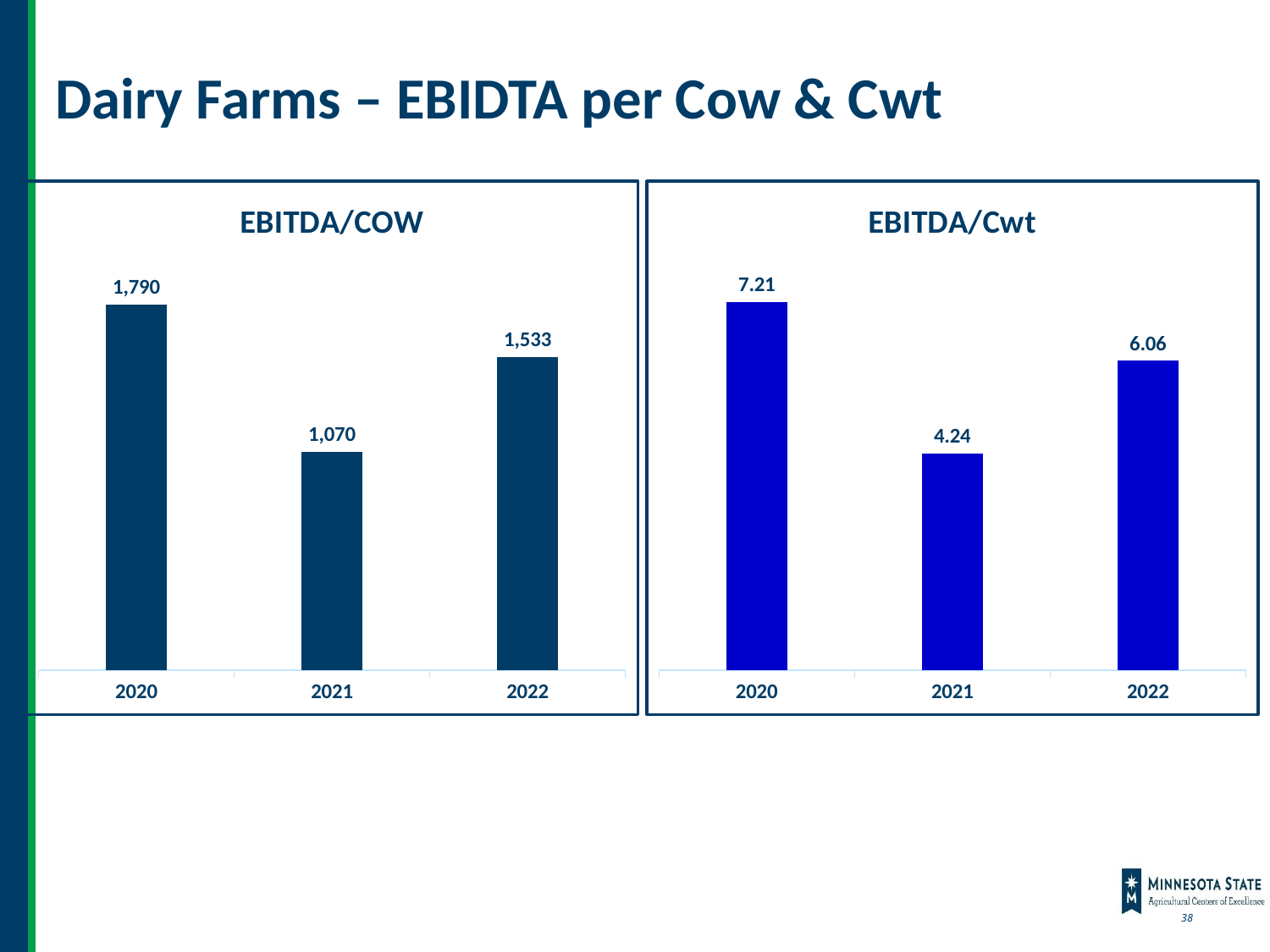
How many years are shown in the EBITDA/COW chart? 3 In the EBITDA/Cwt chart, what is the difference between the 2020 and 2021 values? 2.97 In the EBITDA/Cwt chart, what is the value for 2022? 6.06 In the EBITDA/COW chart, which year has the highest value? 2020 In the EBITDA/Cwt chart, which year has the lowest value? 2021 In the EBITDA/Cwt chart, which is larger, the value for 2020 or the value for 2022? 2020 What kind of chart is the EBITDA/Cwt chart? Bar chart In the EBITDA/COW chart, what is the difference between the 2020 and 2022 values? 257 In the EBITDA/COW chart, does the value rise or fall from 2021 to 2022? Rise In the EBITDA/COW chart, what is the value for 2020? 1,790 In the EBITDA/COW chart, what is the value for 2021? 1,070 In the EBITDA/Cwt chart, what is the value for 2021? 4.24